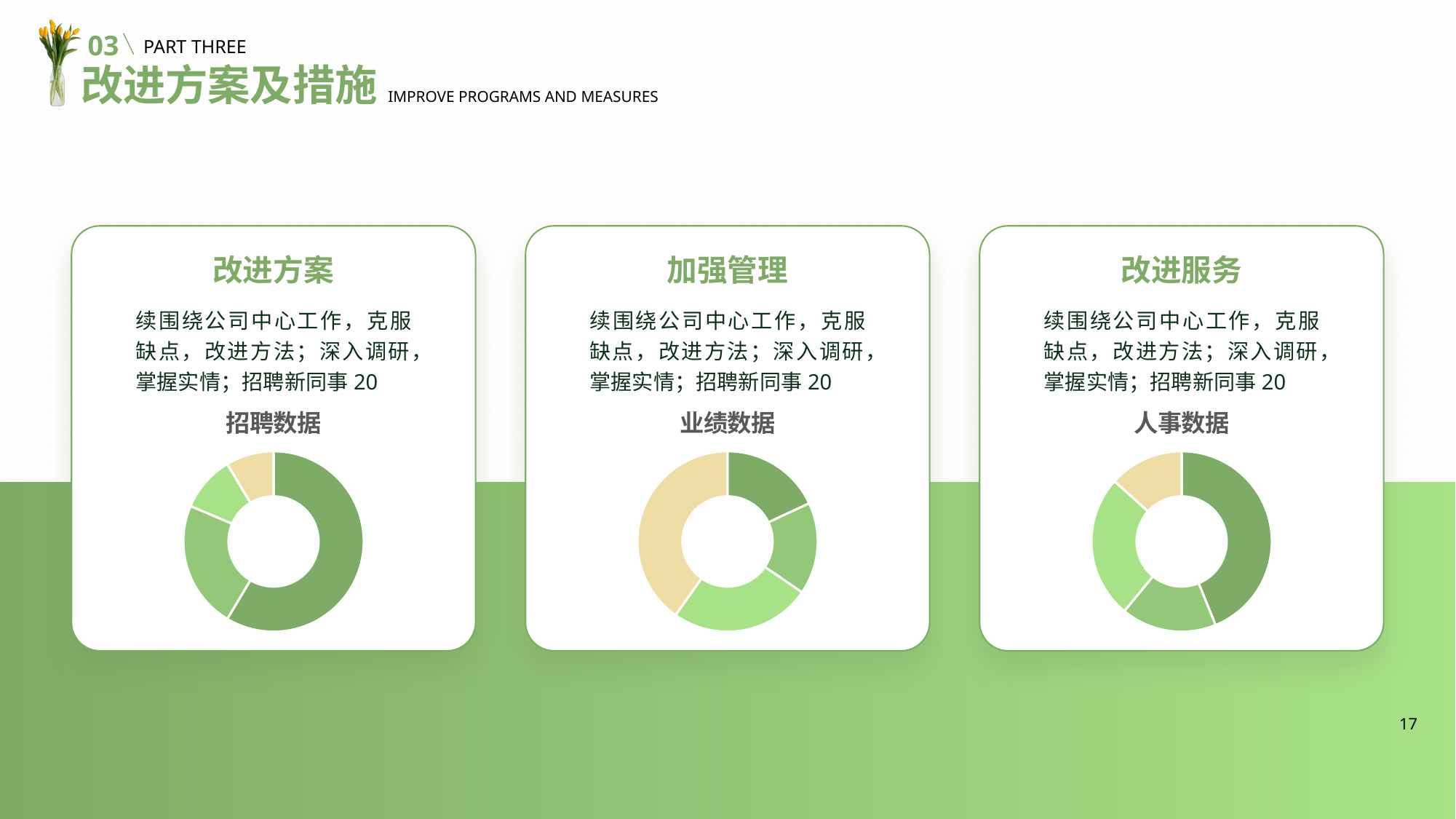
How many slices does the 招聘数据 chart in the left card have? 4 In the 招聘数据 chart in the left card, which colour slice is the largest? Dark green How many slices does the 人事数据 chart in the right card have? 4 In the 业绩数据 chart in the middle card, which colour slice is the largest? Beige What kind of chart is shown under 业绩数据 in the middle card? Donut chart What kind of chart is shown under 招聘数据 in the left card? Donut chart In the 人事数据 chart in the right card, which colour slice is the largest? Dark green In the 招聘数据 chart in the left card, which colour slice is the smallest? Beige How many slices does the 业绩数据 chart in the middle card have? 4 How many donut charts are on the slide? 3 In the 人事数据 chart in the right card, which colour slice is the smallest? Beige What is the title of the chart in the right card? 人事数据